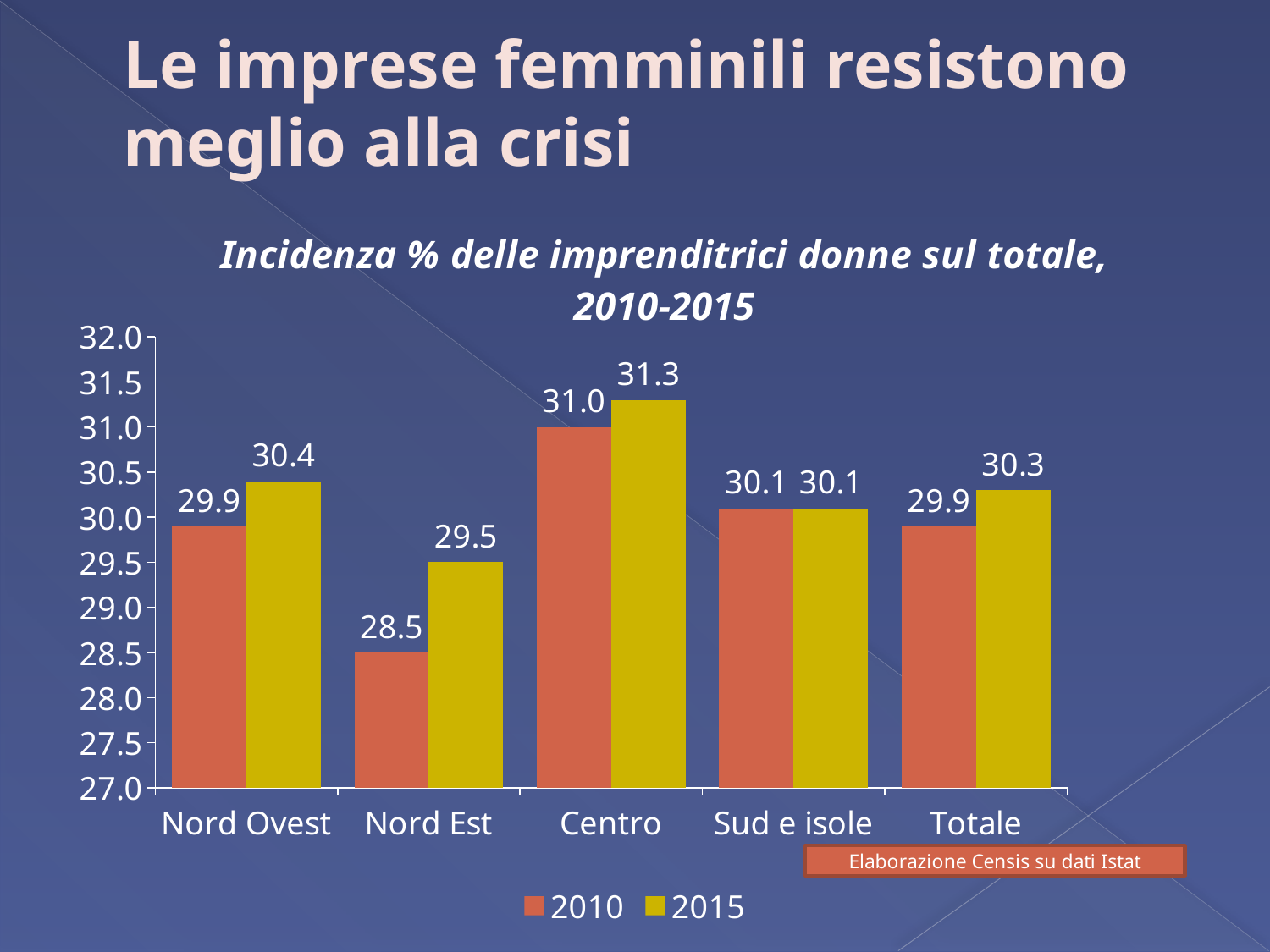
What is the difference between the 2015 and 2010 values for Nord Est? 1.0 Which region has the highest value in 2015? Centro What kind of chart is shown on the slide? Bar chart What is the difference between the 2015 values for Centro and Sud e isole? 1.2 How many categories are shown on the x axis? 5 What is the value for Centro in 2015? 31.3 Which region has the lowest value in 2010? Nord Est What is the value for Nord Est in 2010? 28.5 How many series does the legend list? 2 What is the title of the chart? Incidenza % delle imprenditrici donne sul totale, 2010-2015 Which is larger for Nord Ovest: the 2010 value or the 2015 value? 2015 What is the value for Totale in 2015? 30.3